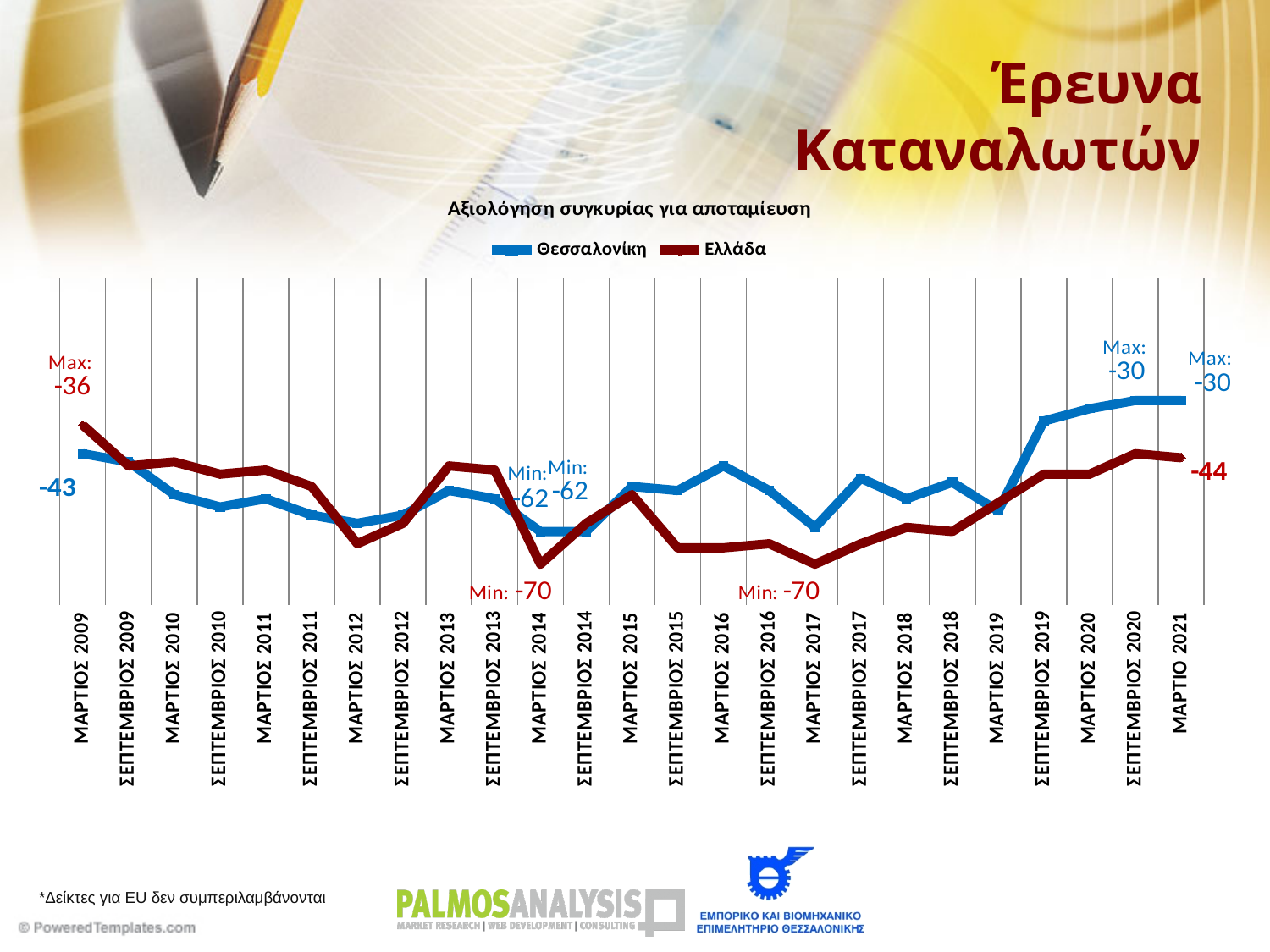
How many series does the legend list? 2 How many time points are plotted along the x axis? 25 What is the title of the chart? Αξιολόγηση συγκυρίας για αποταμίευση What type of chart is shown on the slide? line chart What is the value for Θεσσαλονίκη in ΜΑΡΤΙΟΣ 2009? -43 What is the minimum value reached by the Θεσσαλονίκη series? -62 What is the maximum value reached by the Θεσσαλονίκη series? -30 What is the minimum value reached by the Ελλάδα series? -70 What is the maximum value reached by the Ελλάδα series? -36 In ΜΑΡΤΙΟΣ 2009, which series has the higher value, Θεσσαλονίκη or Ελλάδα? Ελλάδα What is the difference between the Θεσσαλονίκη and Ελλάδα values in ΜΑΡΤΙΟ 2021? 14 What is the value for Ελλάδα in ΜΑΡΤΙΟ 2021? -44